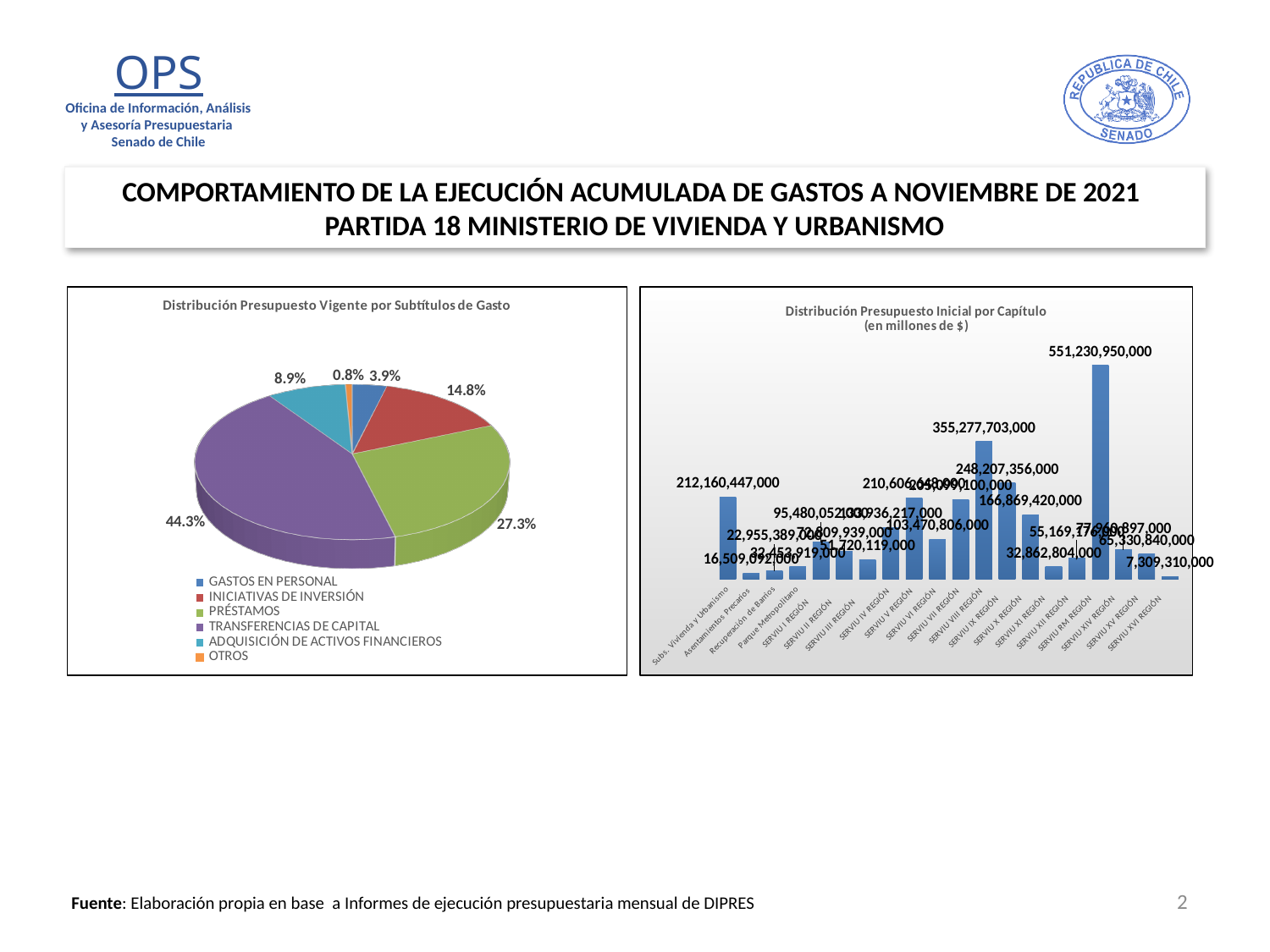
On the chart titled 'Distribución Presupuesto Inicial por Capítulo', what is the value for SERVIU RM REGIÓN? 551,230,950,000 On the chart titled 'Distribución Presupuesto Vigente por Subtítulos de Gasto', what share does TRANSFERENCIAS DE CAPITAL have? 44.3% On the chart titled 'Distribución Presupuesto Vigente por Subtítulos de Gasto', which category has the smallest share? OTROS On the chart titled 'Distribución Presupuesto Vigente por Subtítulos de Gasto', which category has the largest share? TRANSFERENCIAS DE CAPITAL On the chart titled 'Distribución Presupuesto Inicial por Capítulo', what is the value for SERVIU IX REGIÓN? 248,207,356,000 What kind of chart is the one on the right of the slide? Bar chart On the chart titled 'Distribución Presupuesto Inicial por Capítulo', which category has the highest value? SERVIU RM REGIÓN What kind of chart is the one on the left of the slide? Pie chart On the chart titled 'Distribución Presupuesto Vigente por Subtítulos de Gasto', what share does PRÉSTAMOS have? 27.3% On the chart titled 'Distribución Presupuesto Inicial por Capítulo', which category has the lowest value? SERVIU XVI REGIÓN On the chart titled 'Distribución Presupuesto Vigente por Subtítulos de Gasto', what is the difference in percentage points between TRANSFERENCIAS DE CAPITAL and PRÉSTAMOS? 17.0% On the chart titled 'Distribución Presupuesto Vigente por Subtítulos de Gasto', how many categories does the legend list? 6